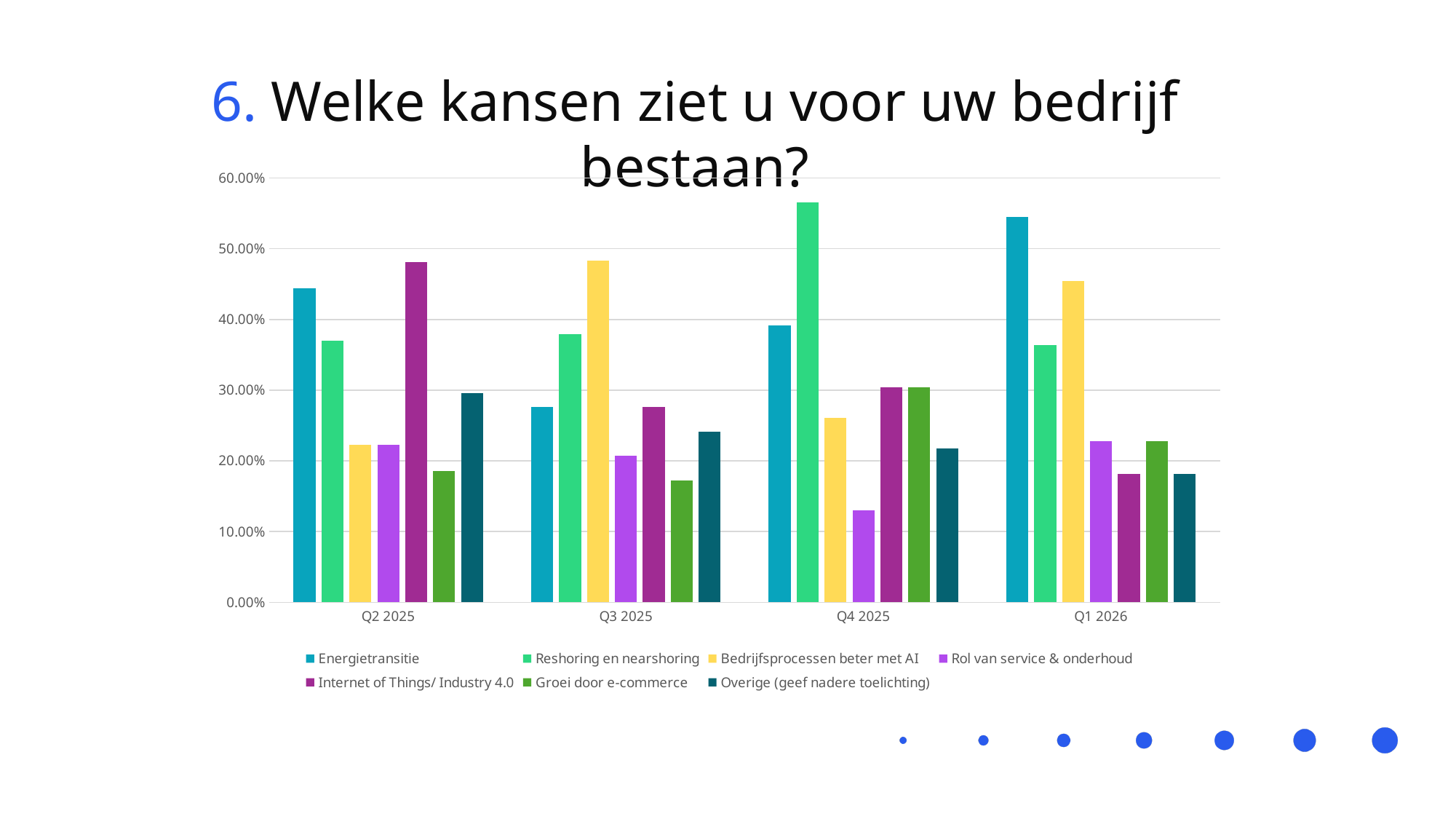
How many quarters are shown on the x axis? 4 Which series is shown in yellow in the legend? Bedrijfsprocessen beter met AI How many series does the legend list? 7 What kind of chart is shown on the slide? bar chart Which series has the highest value in Q2 2025? Internet of Things/ Industry 4.0 Which series has the highest value in Q4 2025? Reshoring en nearshoring Which series has the lowest value in Q4 2025? Rol van service & onderhoud Does the value for Energietransitie rise or fall from Q3 2025 to Q1 2026? rise Is the value for Energietransitie in Q1 2026 greater or less than 50.00%? greater Which series has the highest value in Q3 2025? Bedrijfsprocessen beter met AI Is the value for Rol van service & onderhoud in Q4 2025 greater or less than 20.00%? less Which is larger for Energietransitie: the value in Q2 2025 or in Q3 2025? Q2 2025